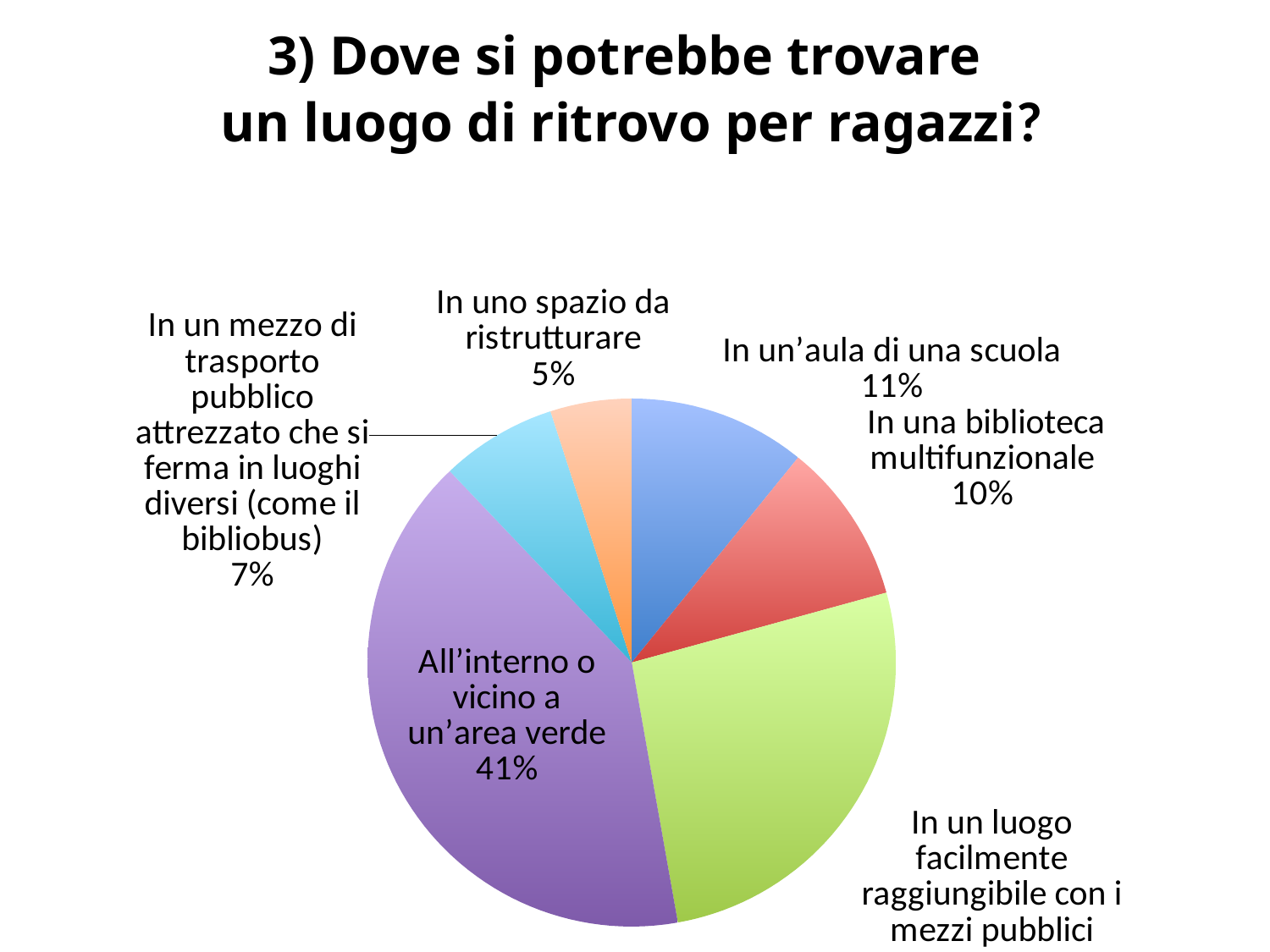
What percentage is shown for "In uno spazio da ristrutturare"? 5% Which category has the smallest slice of the pie? In uno spazio da ristrutturare What percentage is shown for the slice about a public transport vehicle (bibliobus)? 7% What percentage is shown for "In una biblioteca multifunzionale"? 10% What is the title of the slide? 3) Dove si potrebbe trovare un luogo di ritrovo per ragazzi? How many slices does the pie chart have? 6 Which slice is larger: "All'interno o vicino a un'area verde" or "In un luogo facilmente raggiungibile con i mezzi pubblici"? All'interno o vicino a un'area verde What kind of chart is shown on the slide? Pie chart What share of the pie does "All'interno o vicino a un'area verde" represent? 41% What is the difference in percentage points between "All'interno o vicino a un'area verde" and "In un'aula di una scuola"? 30 percentage points Which category has the largest slice of the pie? All'interno o vicino a un'area verde What percentage is shown for "In un'aula di una scuola"? 11%